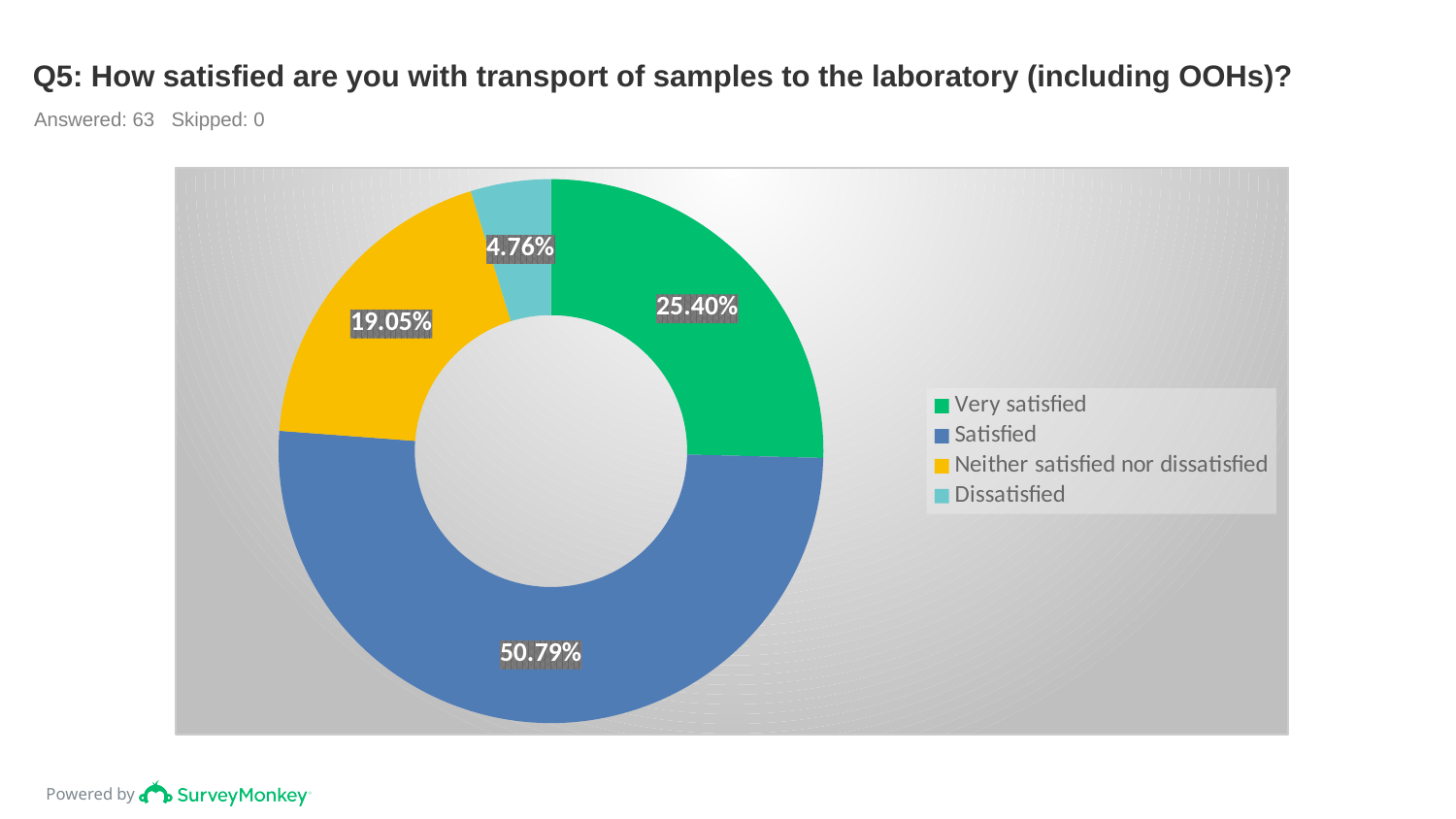
How many respondents answered this question according to the slide? 63 Which response category has the smallest share of the chart? Dissatisfied What colour represents "Neither satisfied nor dissatisfied" in the chart? Yellow Which response category has the largest share of the chart? Satisfied What percentage of respondents answered "Very satisfied"? 25.40% Which is larger: the share for "Very satisfied" or the share for "Neither satisfied nor dissatisfied"? Very satisfied What percentage of respondents answered "Satisfied"? 50.79% What percentage of respondents answered "Neither satisfied nor dissatisfied"? 19.05% What kind of chart is shown on the slide? Pie chart (doughnut) What is the difference in percentage points between "Satisfied" and "Very satisfied"? 25.39 What percentage of respondents answered "Dissatisfied"? 4.76% How many response categories are shown in the chart? 4